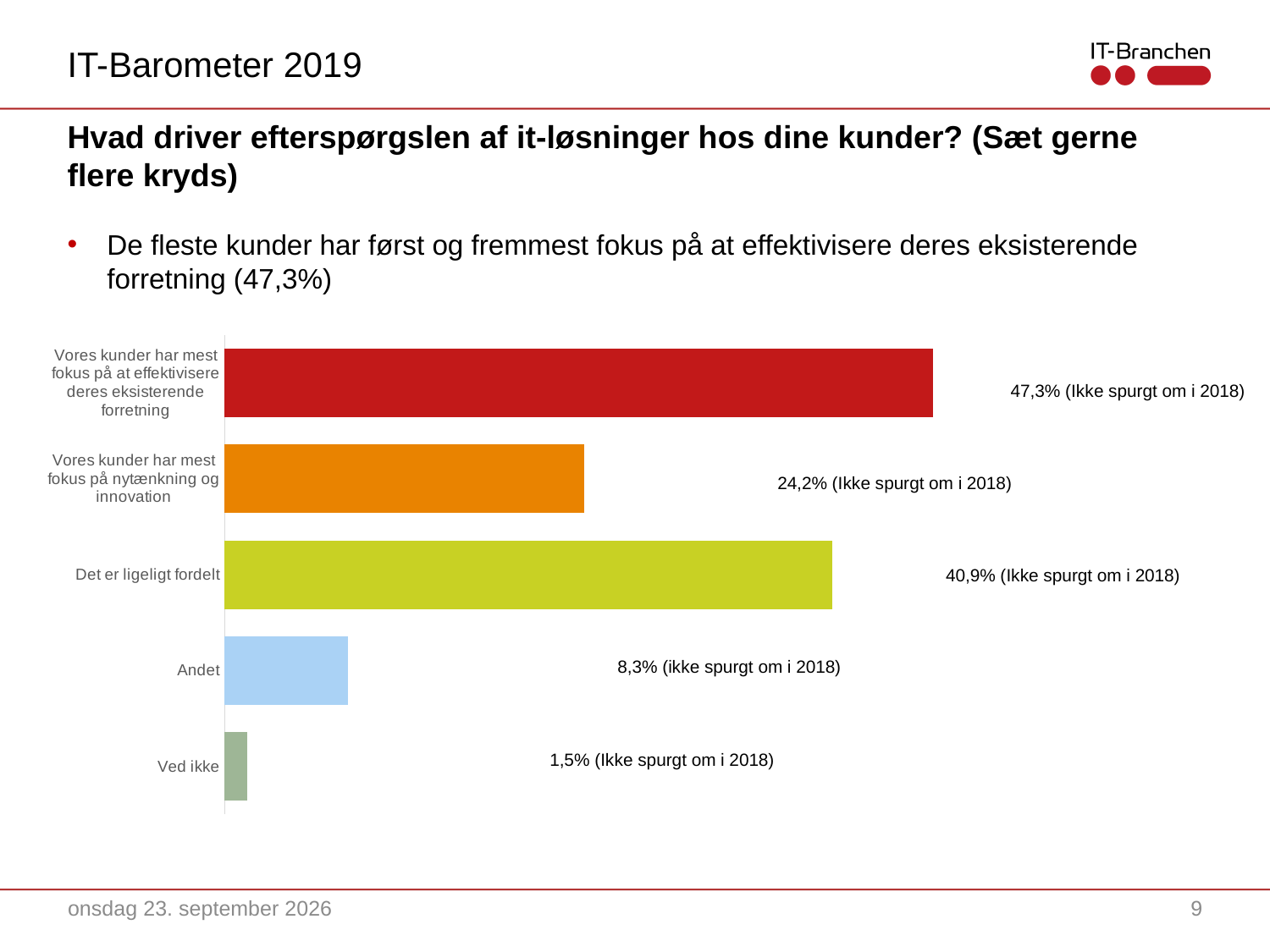
What is the value for "Det er ligeligt fordelt"? 40,9% What is the value for "Vores kunder har mest fokus på nytænkning og innovation"? 24,2% Which category has the lowest value? Ved ikke What is the value for "Andet"? 8,3% What is the value for "Ved ikke"? 1,5% What is the difference between the values for "Vores kunder har mest fokus på at effektivisere deres eksisterende forretning" and "Det er ligeligt fordelt"? 6,4% Which category has the highest value? Vores kunder har mest fokus på at effektivisere deres eksisterende forretning What kind of chart is shown on the slide? Bar chart What note accompanies each data label in the chart? Ikke spurgt om i 2018 What is the value for "Vores kunder har mest fokus på at effektivisere deres eksisterende forretning"? 47,3% How many categories are shown in the chart? 5 Which is larger: the value for "Det er ligeligt fordelt" or the value for "Vores kunder har mest fokus på nytænkning og innovation"? Det er ligeligt fordelt